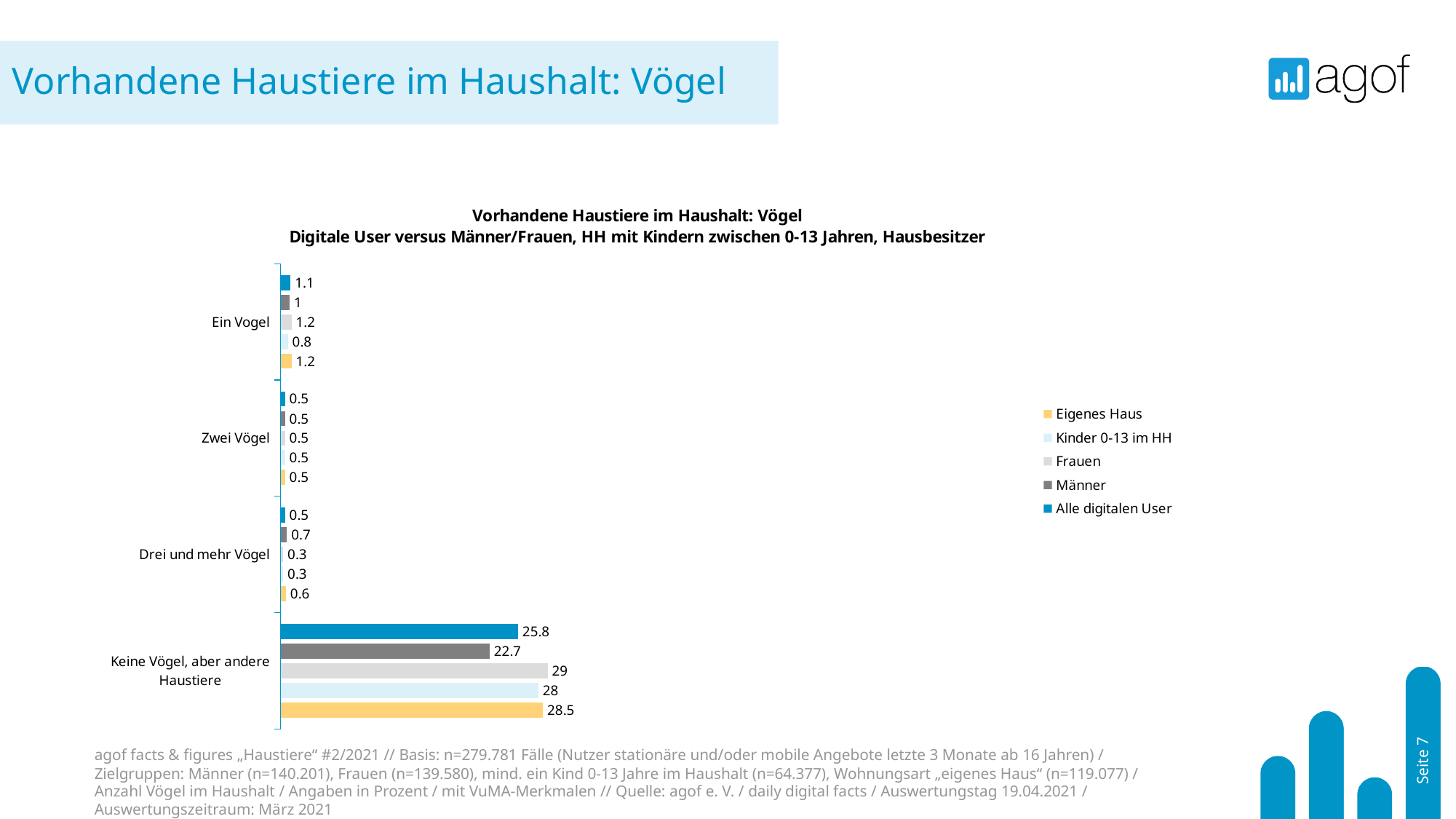
What is the value for "Alle digitalen User" in the category "Keine Vögel, aber andere Haustiere"? 25.8 How many categories are shown on the chart? 4 What is the difference between the "Frauen" and "Männer" values in the category "Keine Vögel, aber andere Haustiere"? 6.3 Which series has the highest value in the category "Keine Vögel, aber andere Haustiere"? Frauen In the category "Drei und mehr Vögel", which is larger: the value for "Männer" or the value for "Eigenes Haus"? Männer Which colour represents the series "Alle digitalen User" in the legend? Blue What kind of chart is shown on the slide? Bar chart What is the value for "Eigenes Haus" in the category "Keine Vögel, aber andere Haustiere"? 28.5 Which series has the lowest value in the category "Ein Vogel"? Kinder 0-13 im HH What is the value for "Kinder 0-13 im HH" in the category "Drei und mehr Vögel"? 0.3 How many series does the legend list? 5 What is the value for "Männer" in the category "Ein Vogel"? 1